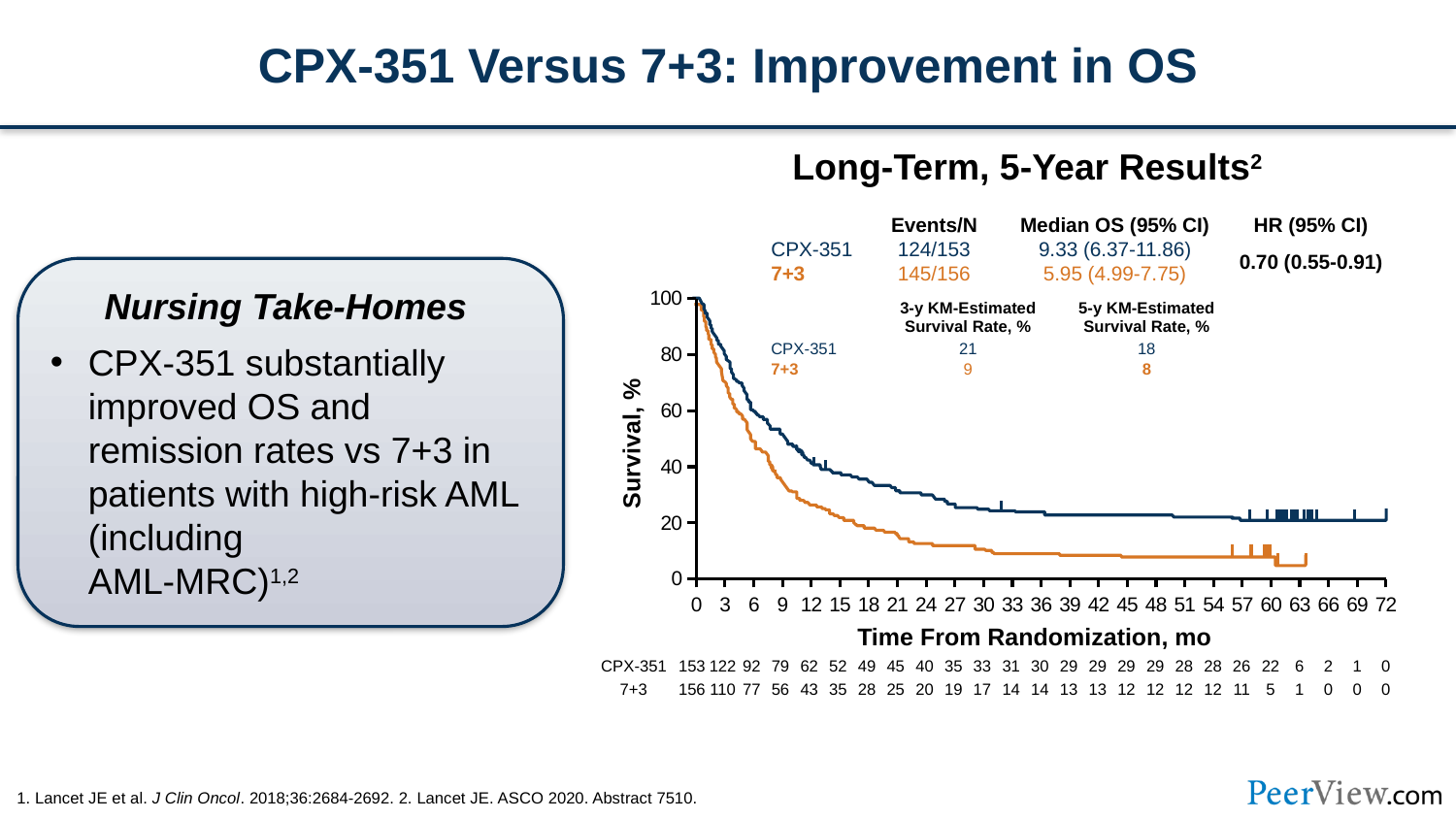
What is the HR (95% CI) shown on the chart? 0.70 (0.55-0.91) How many treatment arms (series) are plotted on the survival chart? 2 Which arm has the higher 5-y KM-estimated survival rate, CPX-351 or 7+3? CPX-351 What kind of chart is shown on the slide? line chart How many 7+3 patients were at risk at 12 months? 43 What is the label of the x axis? Time From Randomization, mo What is the median OS (95% CI) for CPX-351? 9.33 (6.37-11.86) How many CPX-351 patients were at risk at 24 months? 40 What is the Events/N for the 7+3 arm? 145/156 What is the 5-y KM-estimated survival rate for 7+3? 8 Is the CPX-351 survival curve at 48 months greater or less than 40%? less What is the difference between the 3-y KM-estimated survival rates of CPX-351 and 7+3? 12